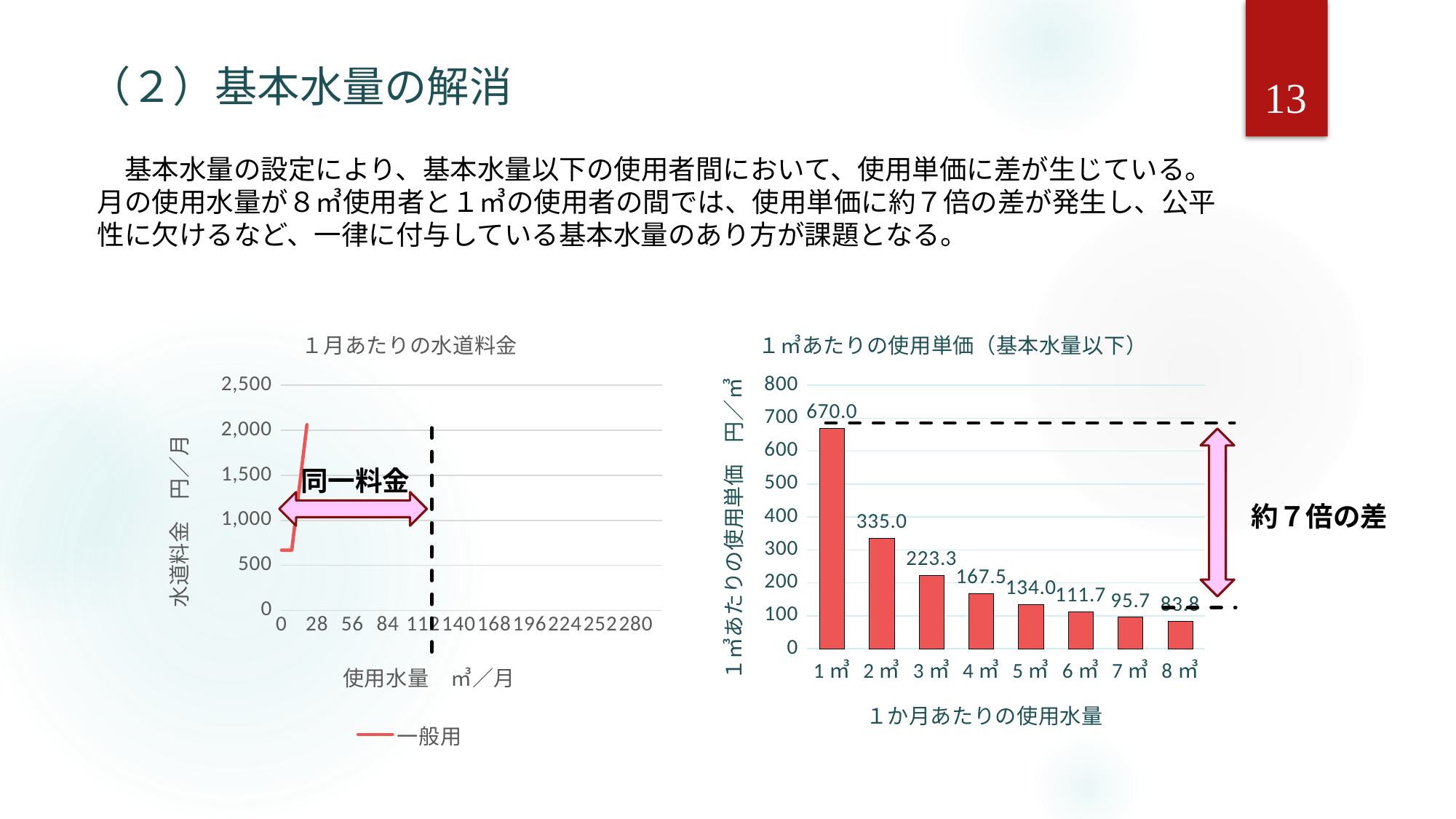
In the chart titled 「１㎥あたりの使用単価（基本水量以下）」, how many categories are shown on the x axis? 8 In the chart titled 「１㎥あたりの使用単価（基本水量以下）」, what is the difference between the values for 1 ㎥ and 2 ㎥? 335.0 In the chart titled 「１㎥あたりの使用単価（基本水量以下）」, which category has the lowest value? 8 ㎥ In the chart titled 「１㎥あたりの使用単価（基本水量以下）」, what is the value for 8 ㎥? 83.8 What kind of chart is the chart titled 「１㎥あたりの使用単価（基本水量以下）」? bar chart In the chart titled 「１㎥あたりの使用単価（基本水量以下）」, which is larger, the value for 3 ㎥ or the value for 6 ㎥? 3 ㎥ In the chart titled 「１月あたりの水道料金」, what series name does the legend show? 一般用 In the chart titled 「１㎥あたりの使用単価（基本水量以下）」, which category has the highest value? 1 ㎥ In the chart titled 「１㎥あたりの使用単価（基本水量以下）」, what is the value for 1 ㎥? 670.0 In the chart titled 「１㎥あたりの使用単価（基本水量以下）」, do the values rise or fall as the usage volume increases along the x axis? fall In the chart titled 「１㎥あたりの使用単価（基本水量以下）」, what is the value for 4 ㎥? 167.5 What kind of chart is the chart titled 「１月あたりの水道料金」? line chart